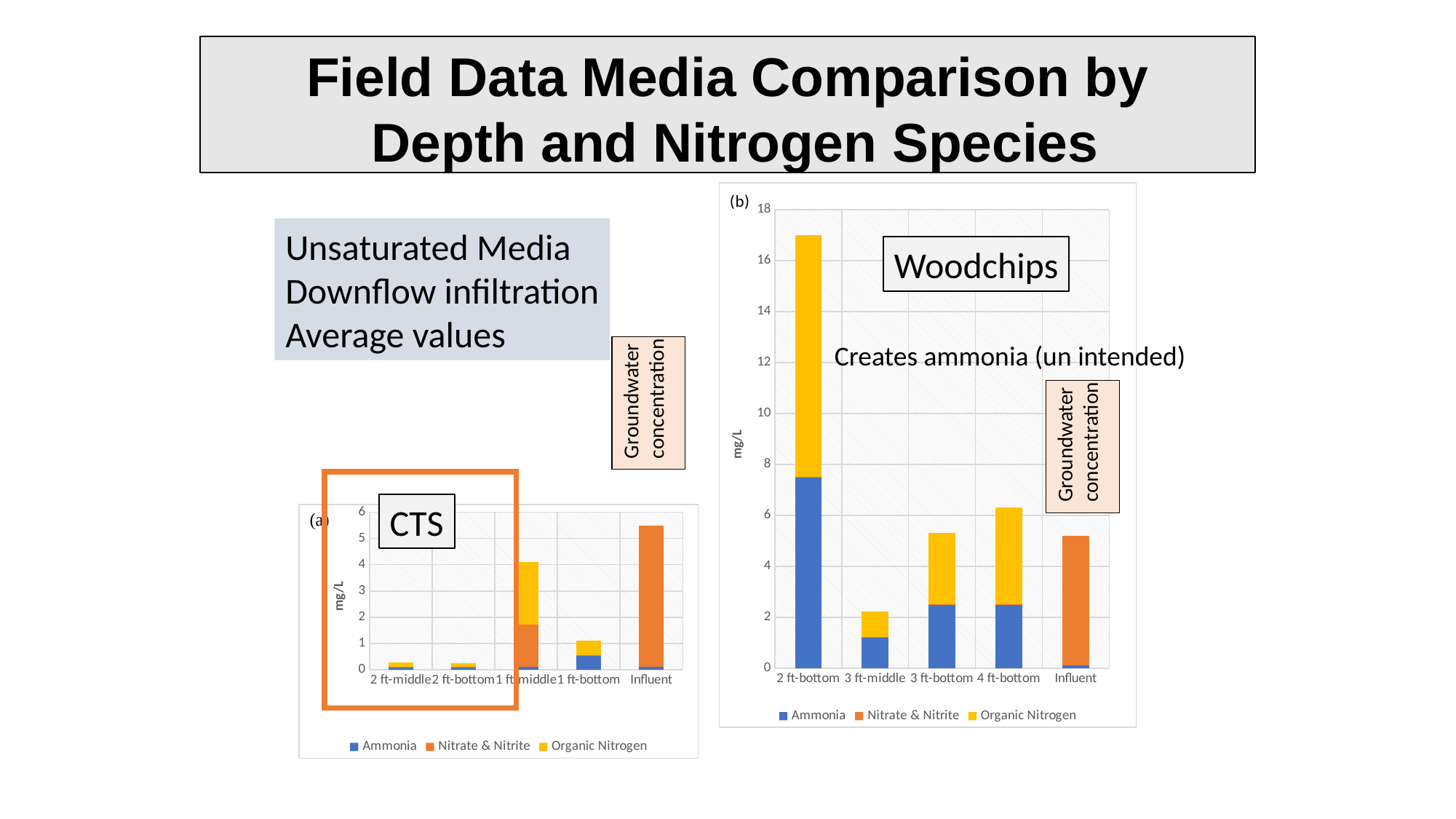
How many categories are shown on the x axis of the Woodchips chart (b)? 5 In the Woodchips chart (b), is the total value for 2 ft-bottom greater or less than 16? greater In the CTS chart (a), which category has the highest total bar? Influent In the Woodchips chart (b), is the total value for Influent greater or less than 4? greater In the CTS chart (a), is the total value for 1 ft-middle greater or less than 3? greater What kind of chart is the Woodchips chart (b)? Stacked bar chart In the Woodchips chart (b), which category has the lowest total bar? 3 ft-middle In the Woodchips chart (b), which has the larger total bar, 3 ft-bottom or 4 ft-bottom? 4 ft-bottom In the Woodchips chart (b), which category has the highest total bar? 2 ft-bottom How many series does the legend of the CTS chart (a) list? 3